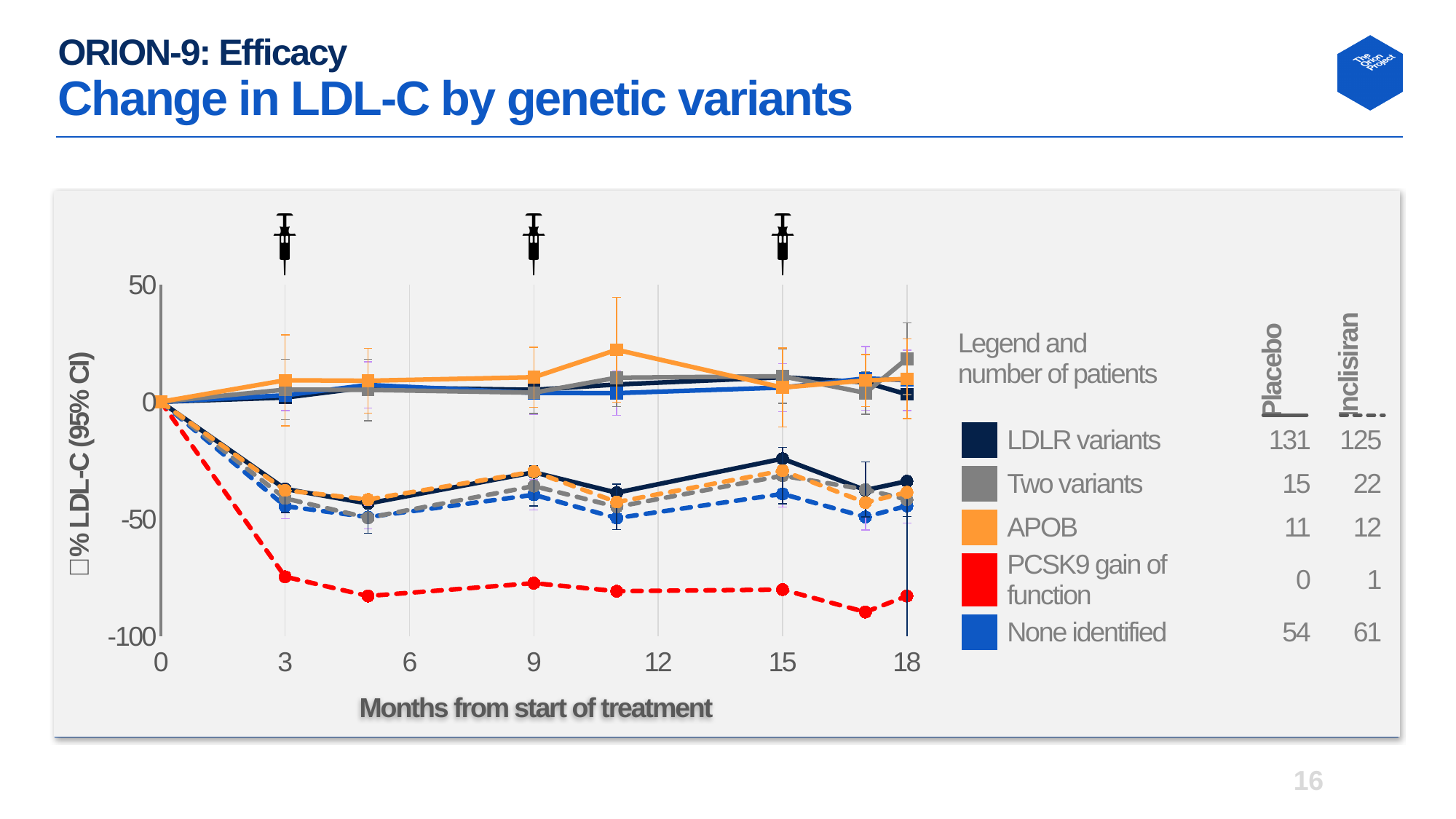
Does the PCSK9 gain of function inclisiran (red dashed) line rise or fall between month 0 and month 3? fall How many tick labels are shown on the x axis? 7 Is the value for the APOB placebo (orange solid) line at month 11 greater or less than 0? greater Is the value for the PCSK9 gain of function inclisiran (red dashed) line at month 17 greater or less than -50? less What is the title of the x axis? Months from start of treatment How many placebo patients with LDLR variants are listed in the legend? 131 What kind of chart is shown on the slide? line chart Is the value for the PCSK9 gain of function inclisiran (red dashed) line at month 3 greater or less than -50? less How many inclisiran patients with no variant identified are listed in the legend? 61 How many genetic variant groups does the legend list? 5 Which group's inclisiran line is lowest at month 18? PCSK9 gain of function